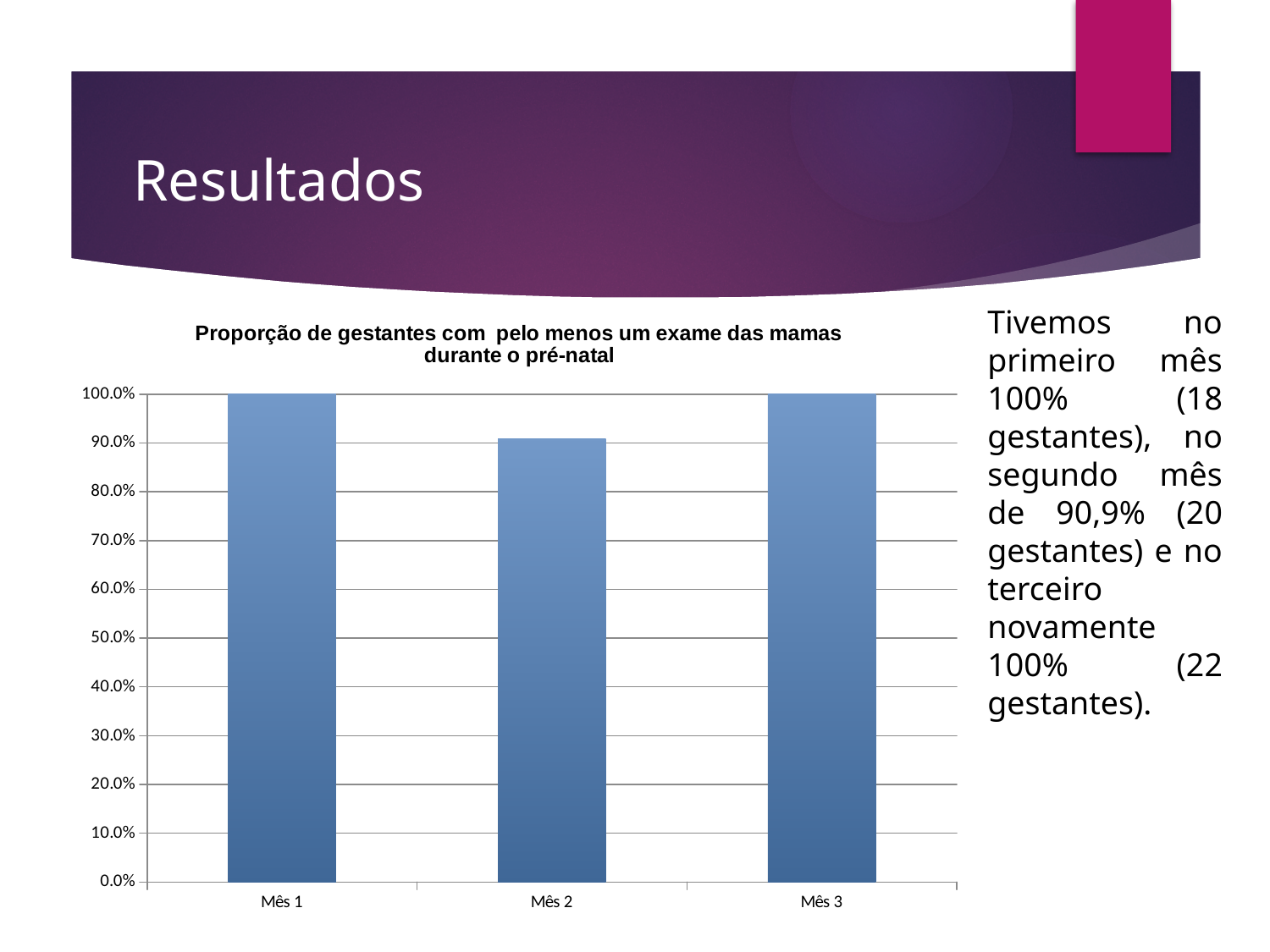
What is the value for Mês 3? 100.0% Do the values rise or fall from Mês 2 to Mês 3? Rise What is the title of the chart? Proporção de gestantes com pelo menos um exame das mamas durante o pré-natal Is the value for Mês 2 greater or less than 90.0%? greater What is the value for Mês 1? 100.0% Which month has the lowest value? Mês 2 Is the value for Mês 2 greater or less than 100.0%? less Which is larger, the value for Mês 2 or the value for Mês 3? Mês 3 Do the values rise or fall from Mês 1 to Mês 2? Fall What kind of chart is shown on the slide? Bar chart Which is larger, the value for Mês 1 or the value for Mês 2? Mês 1 How many categories are shown on the x axis? 3